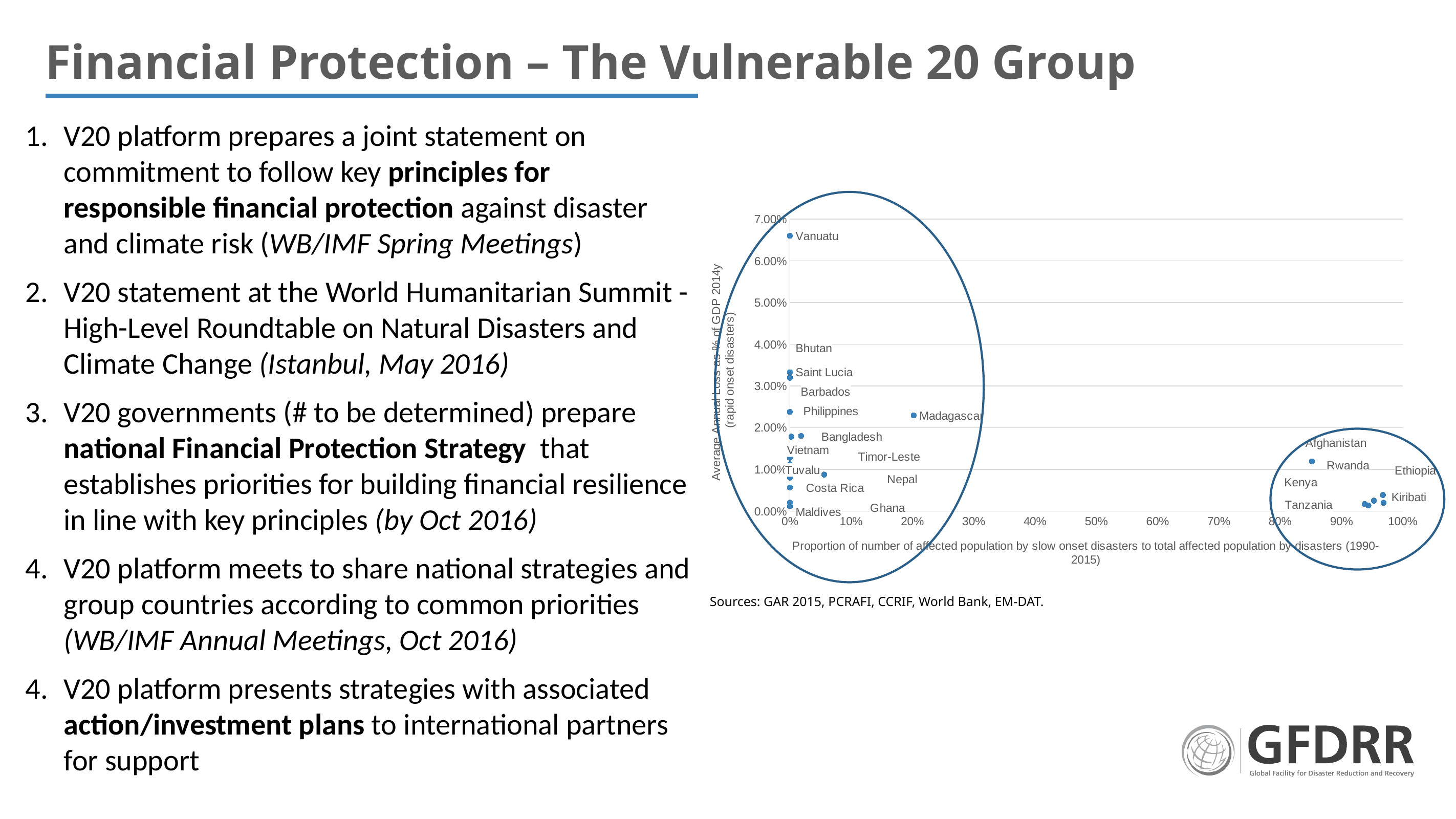
Which has a higher average annual loss as % of GDP, Vanuatu or Madagascar? Vanuatu Which has a higher average annual loss as % of GDP, Bhutan or Maldives? Bhutan What sources are cited below the chart? GAR 2015, PCRAFI, CCRIF, World Bank, EM-DAT Is the proportion of affected population (x-axis) for Madagascar greater or less than 10%? greater Is the proportion of affected population (x-axis) for Kiribati greater or less than 90%? greater What is the highest tick value shown on the chart's vertical axis? 7.00% Which has a higher proportion of affected population by slow onset disasters (x-axis), Madagascar or Vanuatu? Madagascar Which country has the highest average annual loss as % of GDP on the chart? Vanuatu Is the average annual loss value for Madagascar greater or less than 3.00%? less What kind of chart is shown on the slide? scatter chart